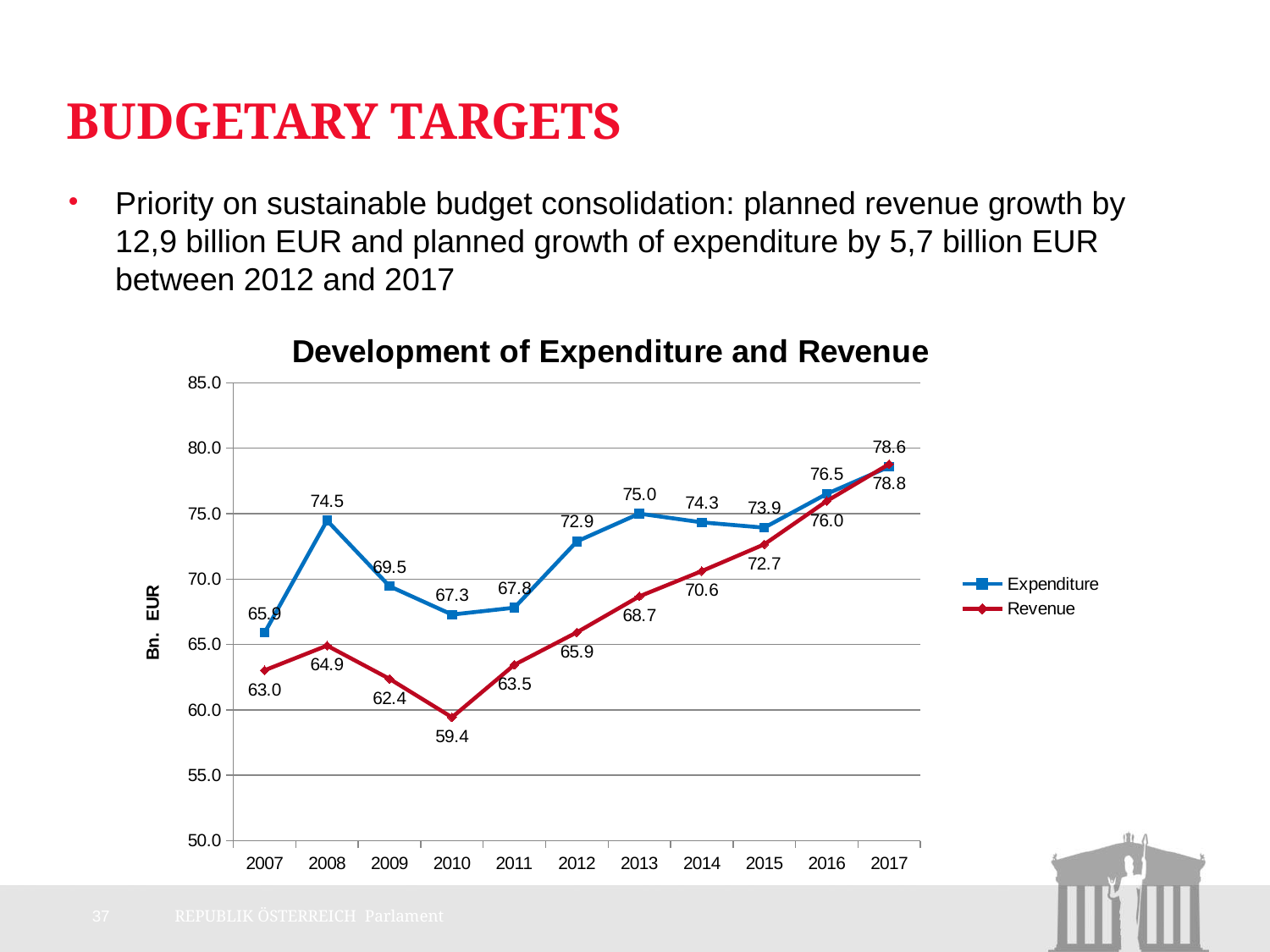
How many years are shown on the x axis? 11 Which is larger in 2013, Expenditure or Revenue? Expenditure Is the Revenue value for 2009 greater or less than 65.0? less In which year is Revenue lowest? 2010 What is the Revenue value for 2010? 59.4 Does Revenue rise or fall from 2010 to 2017? rise What is the Expenditure value for 2008? 74.5 In which year is Expenditure highest? 2017 What is the Revenue value for 2015? 72.7 What is the difference between Expenditure and Revenue in 2012? 7.0 How many series does the legend list? 2 What kind of chart is shown? line chart